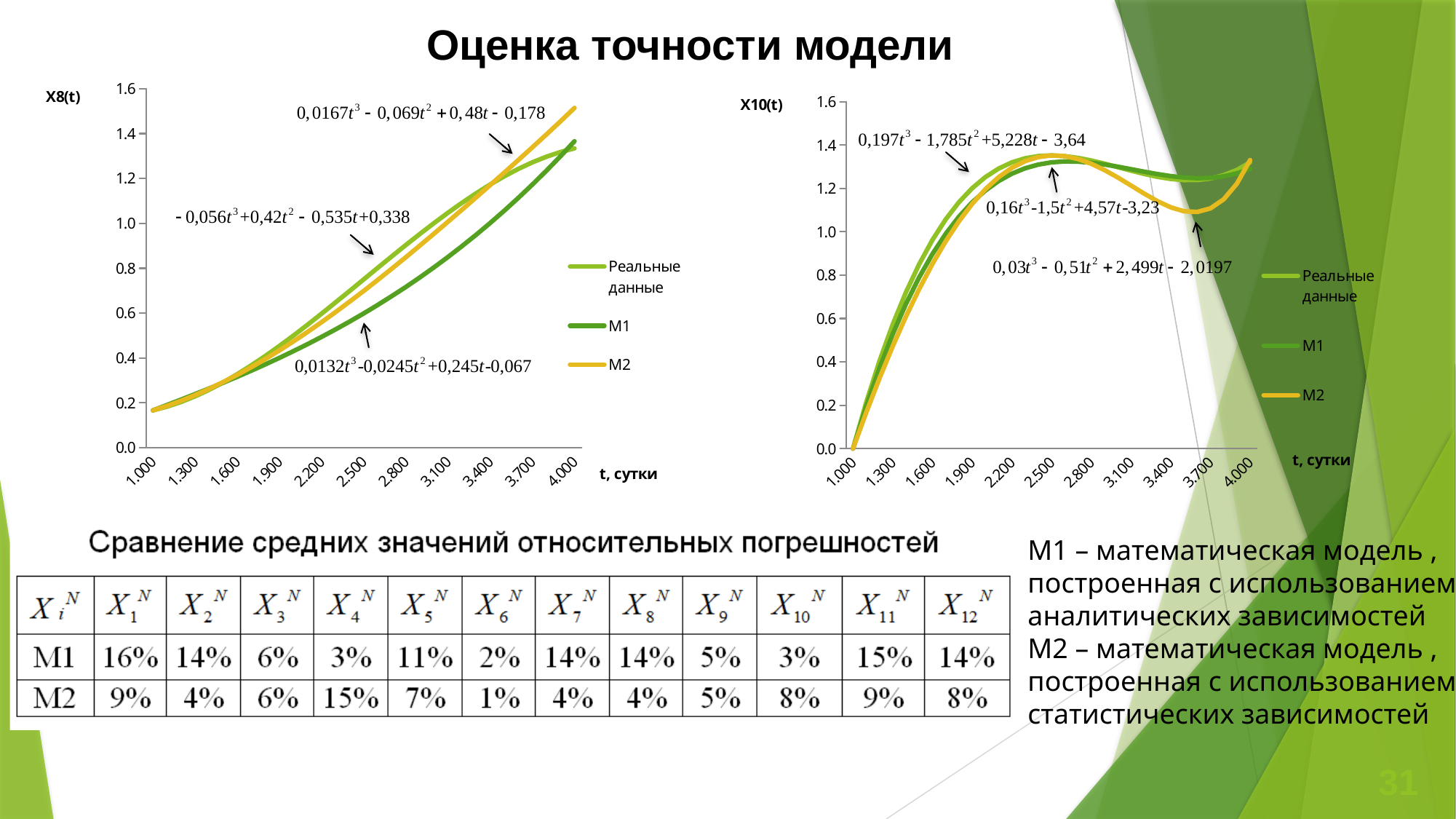
What kind of chart is the left chart, X8(t)? line chart In the right chart, X10(t), at t = 3.700, which is larger: Реальные данные or M2? Реальные данные How many tick labels are shown on the x axis of the left chart, X8(t)? 11 How many series does the legend of the left chart, X8(t), list? 3 In the left chart, X8(t), is the value of M2 at t = 4.000 greater or less than 1.4? greater How many series does the legend of the right chart, X10(t), list? 3 What is the x-axis label of the left chart, X8(t)? t, сутки In the left chart, X8(t), which series reaches the highest value at t = 4.000? M2 In the left chart, X8(t), is the value of M1 at t = 2.200 greater or less than 0.6? less In the left chart, X8(t), do the values of the M1 series rise or fall as t increases from 1.000 to 4.000? rise In the right chart, X10(t), is the value of Реальные данные at t = 2.500 greater or less than 1.2? greater